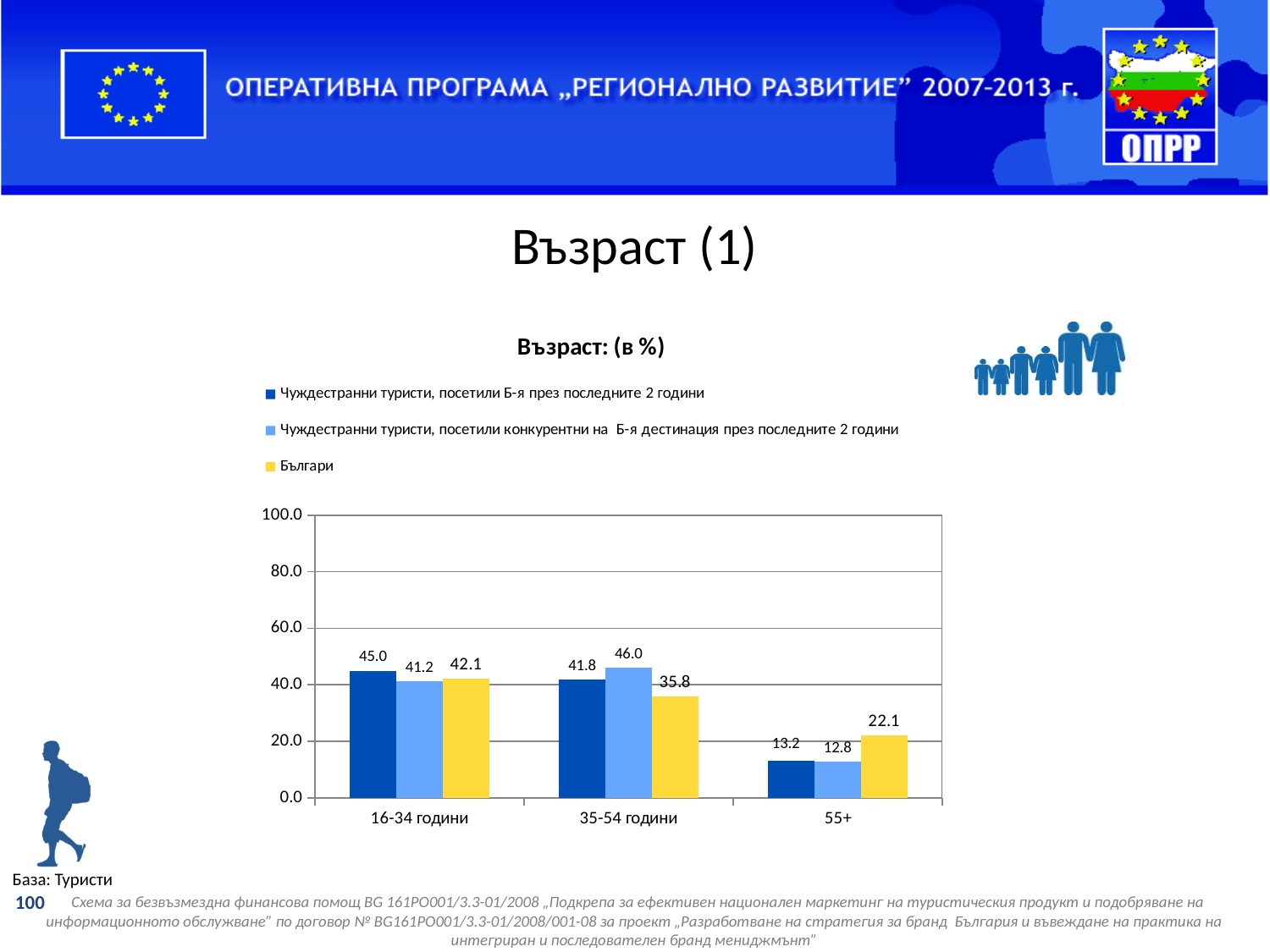
What type of chart is shown on the slide? bar chart What is the difference between the Българи value and the Чуждестранни туристи, посетили Б-я през последните 2 години value in the 55+ group? 8.9 What is the title of the chart? Възраст: (в %) What is the value for Чуждестранни туристи, посетили Б-я през последните 2 години in the 16-34 години group? 45.0 In the 35-54 години group, which is larger: the value for Чуждестранни туристи, посетили Б-я през последните 2 години or the value for Българи? Чуждестранни туристи, посетили Б-я през последните 2 години How many series does the legend list? 3 Which age group has the lowest value for Българи? 55+ Which age group has the highest value for Чуждестранни туристи, посетили конкурентни на Б-я дестинация през последните 2 години? 35-54 години What is the value for Чуждестранни туристи, посетили конкурентни на Б-я дестинация през последните 2 години in the 35-54 години group? 46.0 Is the value for Българи in the 16-34 години group greater or less than 40.0? greater What is the value for Българи in the 55+ age group? 22.1 How many age groups are shown on the x axis? 3